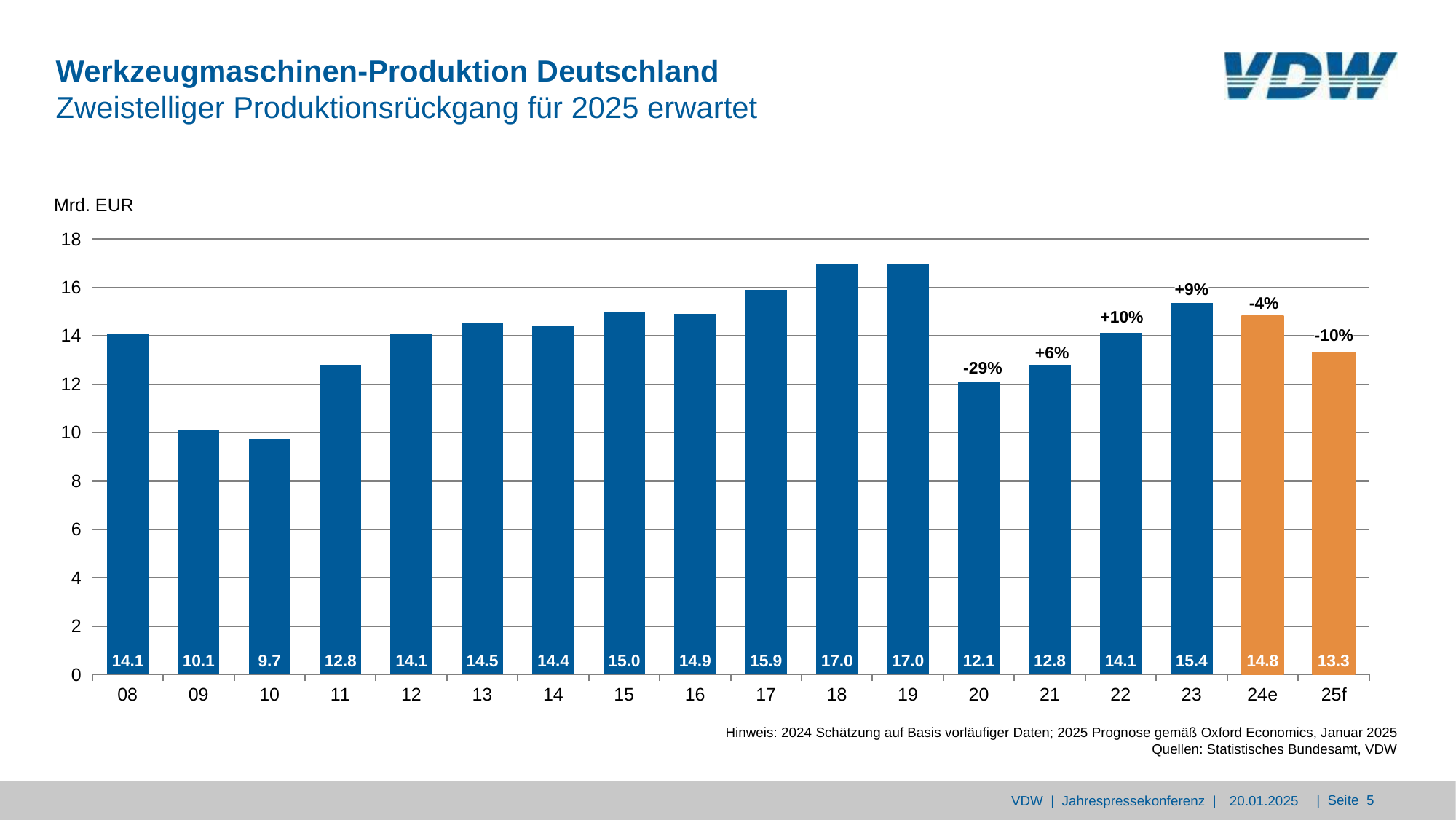
Which is larger, the value for 17 or the value for 22? 17 Which year has the lowest value? 10 What is the difference between the values for 19 and 20? 4.9 What is the value for 25f? 13.3 Is the value for 18 greater or less than 16? greater What kind of chart is shown on the slide? bar chart What is the value for 2010 (10)? 9.7 How many bars are shown in the chart? 18 What percentage change is labelled above the bar for 20? -29% What is the difference between the values for 23 and 24e? 0.6 What unit is shown on the y axis of the chart? Mrd. EUR What is the value for 2023 (23)? 15.4